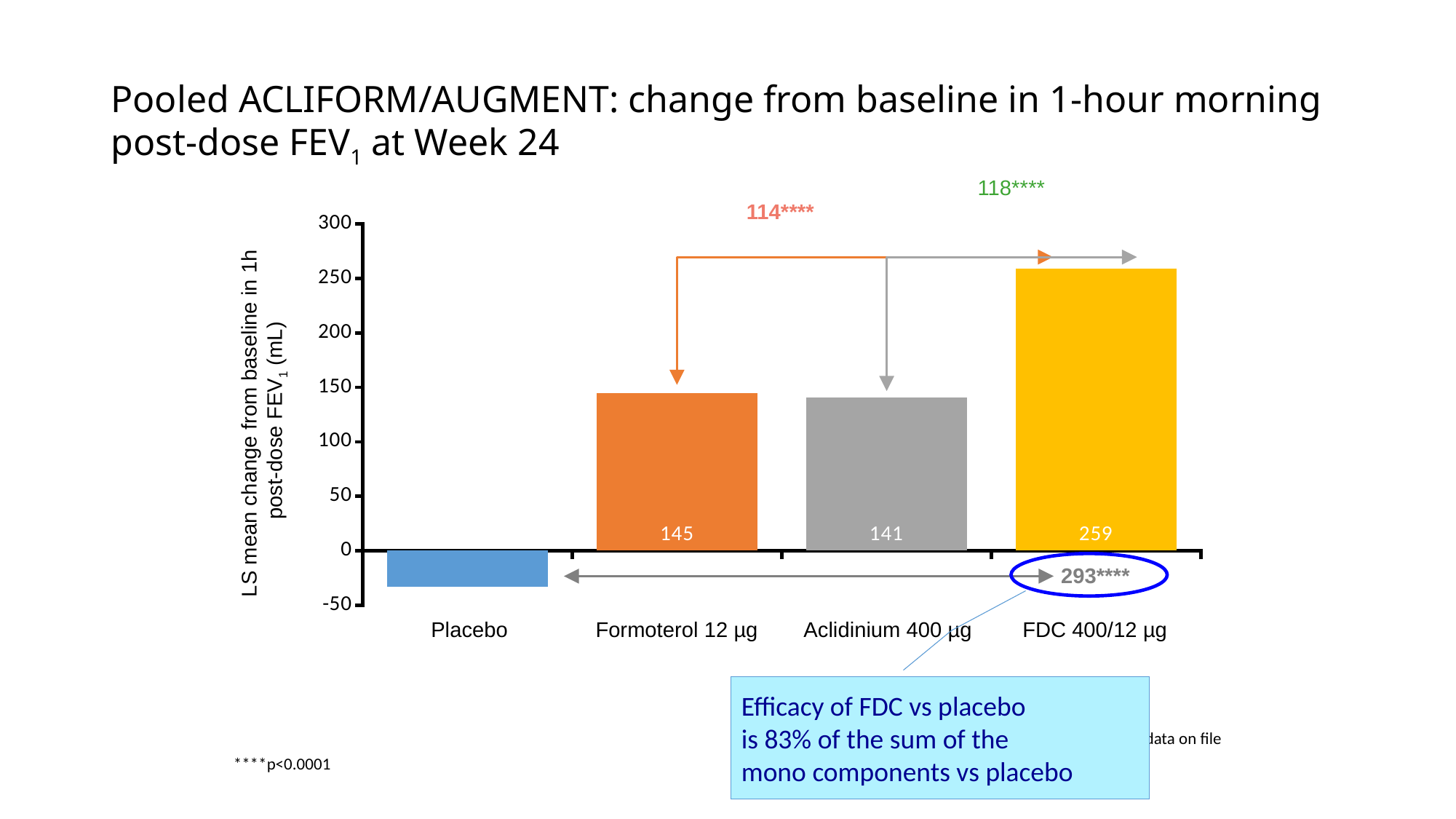
What is the value for FDC 400/12 µg? 259 What is the difference between the values for FDC 400/12 µg and Formoterol 12 µg? 114 Which category has the lowest value? Placebo What is the value for Formoterol 12 µg? 145 Which is larger, the value for Formoterol 12 µg or the value for Aclidinium 400 µg? Formoterol 12 µg What is the label of the y axis? LS mean change from baseline in 1h post-dose FEV1 (mL) How many categories are shown on the x axis? 4 What is the value for Aclidinium 400 µg? 141 Is the value for Placebo greater or less than 0? less Which category has the highest value? FDC 400/12 µg What is the difference between the values for FDC 400/12 µg and Aclidinium 400 µg? 118 What kind of chart is shown on the slide? bar chart